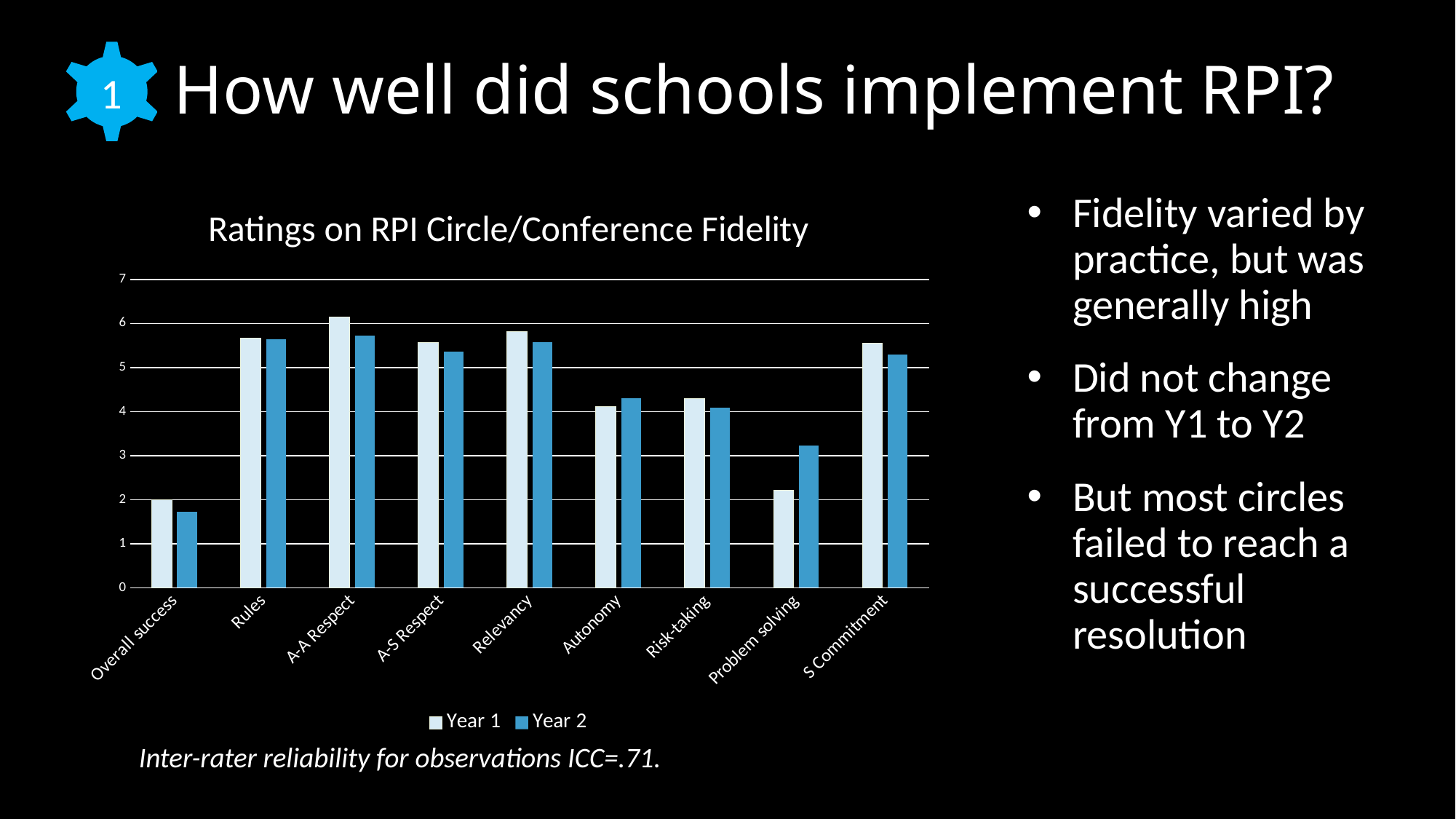
Is the Year 2 value for Overall success greater or less than 2? less For A-A Respect, which is larger: the Year 1 or the Year 2 rating? Year 1 What is the title of the chart? Ratings on RPI Circle/Conference Fidelity Is the Year 2 value for Problem solving greater or less than 3? greater How many series does the chart's legend list? 2 What kind of chart is shown on the slide? Bar chart Is the Year 1 value for A-A Respect greater or less than 6? greater How many categories are shown on the x axis of the chart? 9 For Problem solving, which is larger: the Year 1 or the Year 2 rating? Year 2 Which category has the highest Year 1 rating? A-A Respect Which category has the lowest Year 2 rating? Overall success